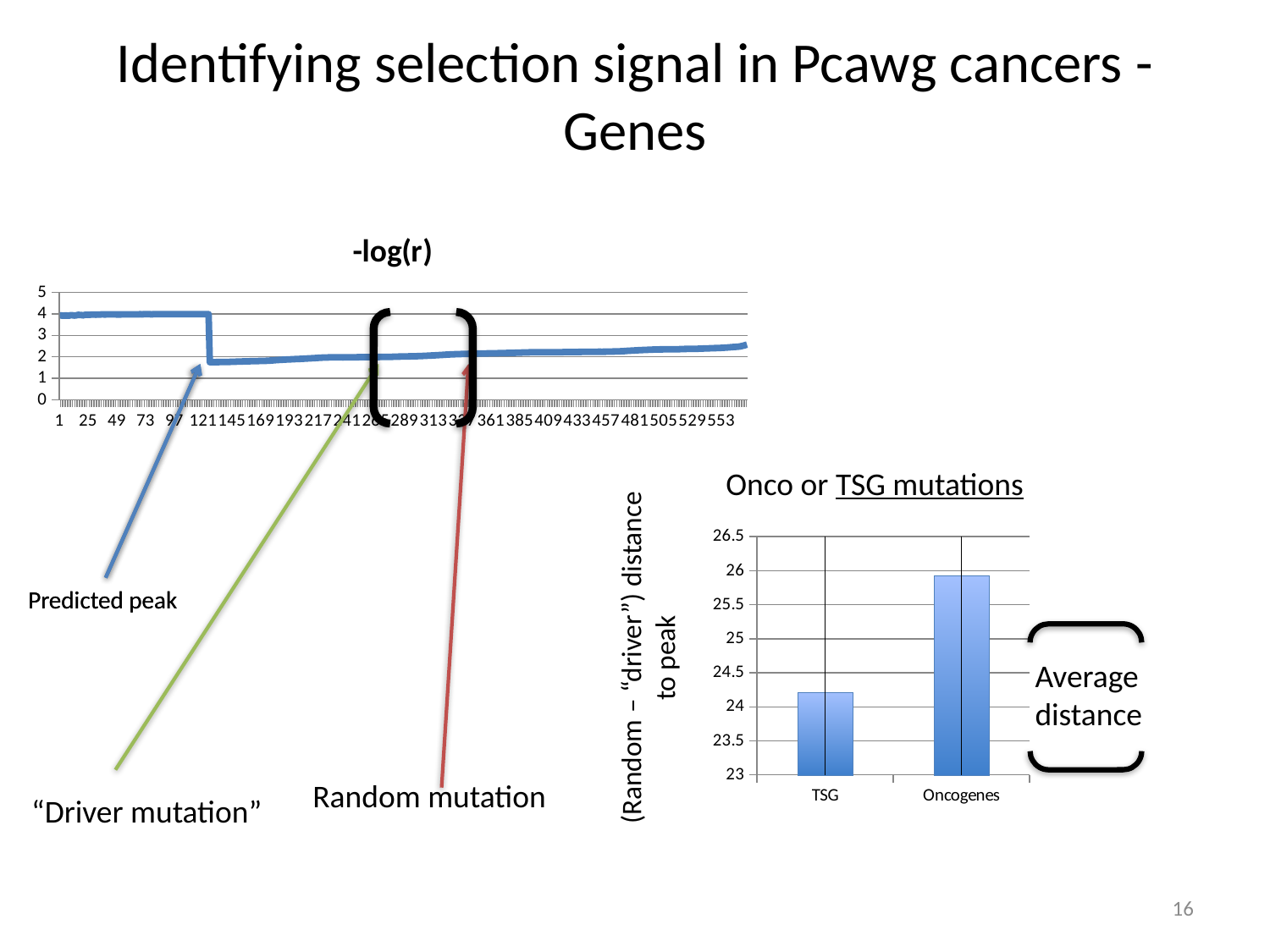
In the chart titled "Onco or TSG mutations", is the value for TSG greater or less than 24? greater In the chart titled "Onco or TSG mutations", which is larger, the value for TSG or the value for Oncogenes? Oncogenes In the chart titled "Onco or TSG mutations", is the value for Oncogenes greater or less than 25.5? greater In the chart titled "Onco or TSG mutations", is the value for TSG greater or less than 24.5? less What kind of chart is the chart titled "Onco or TSG mutations"? bar chart In the chart titled "Onco or TSG mutations", how many categories are shown on the x axis? 2 In the chart titled "Onco or TSG mutations", which category has the lowest bar? TSG In the chart titled "Onco or TSG mutations", which category has the highest bar? Oncogenes What is the y-axis label of the chart titled "Onco or TSG mutations"? (Random – "driver") distance to peak What kind of chart is the chart titled "-log(r)"? line chart